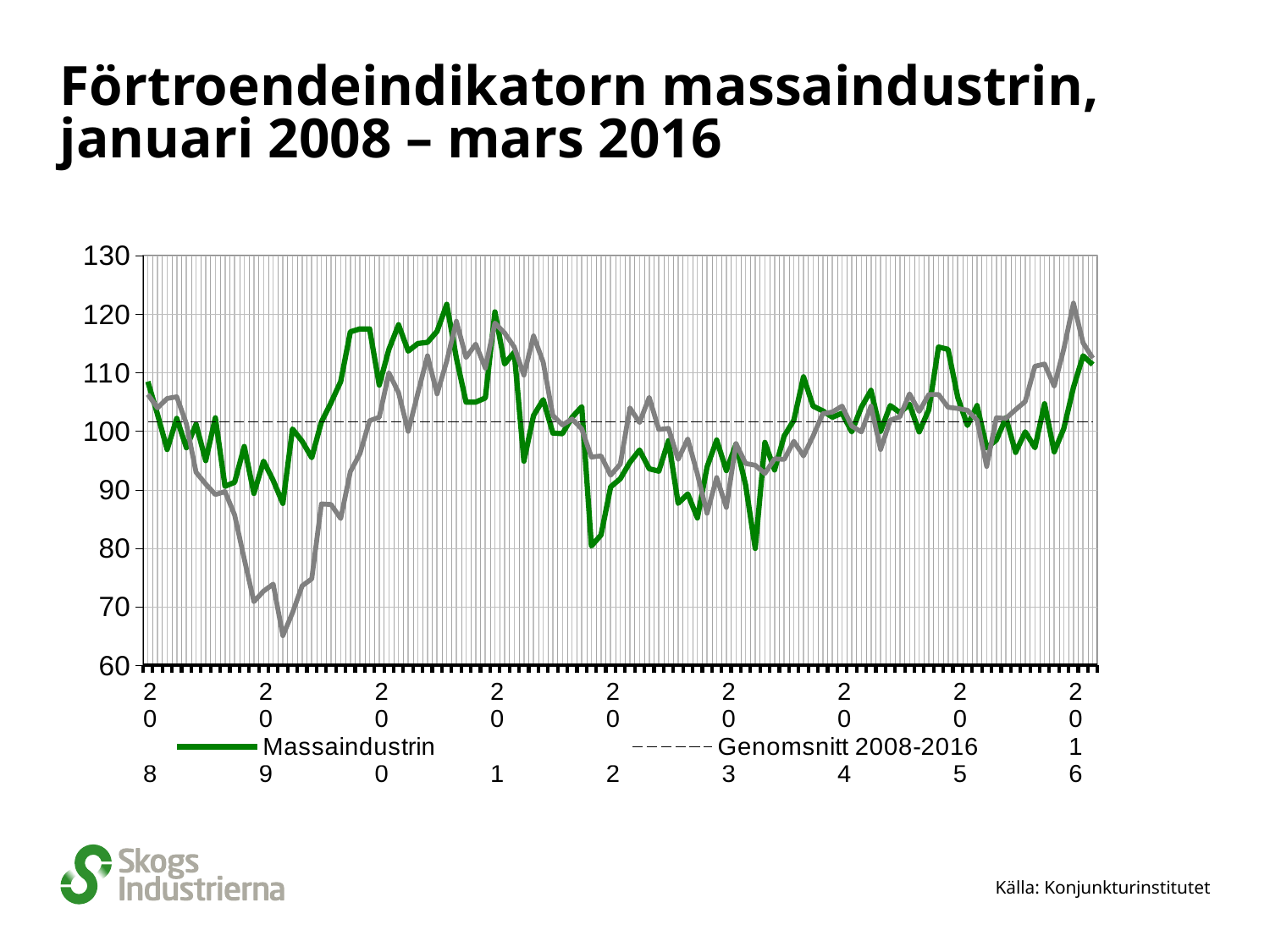
Is the value for Massaindustrin at the end of the series (March 2016) greater or less than 100? greater Is the Genomsnitt 2008-2016 line greater or less than 110? less Is the value for Massaindustrin at the start of 2008 greater or less than 100? greater What kind of chart is shown on the slide? line chart How many series does the legend list? 2 What is the title of the chart? Förtroendeindikatorn massaindustrin, januari 2008 – mars 2016 What is the highest value shown on the y axis? 130 What colour is the Massaindustrin line? green How many year labels are shown on the x axis? 9 Does the Massaindustrin line rise or fall from early 2009 to early 2010? rise